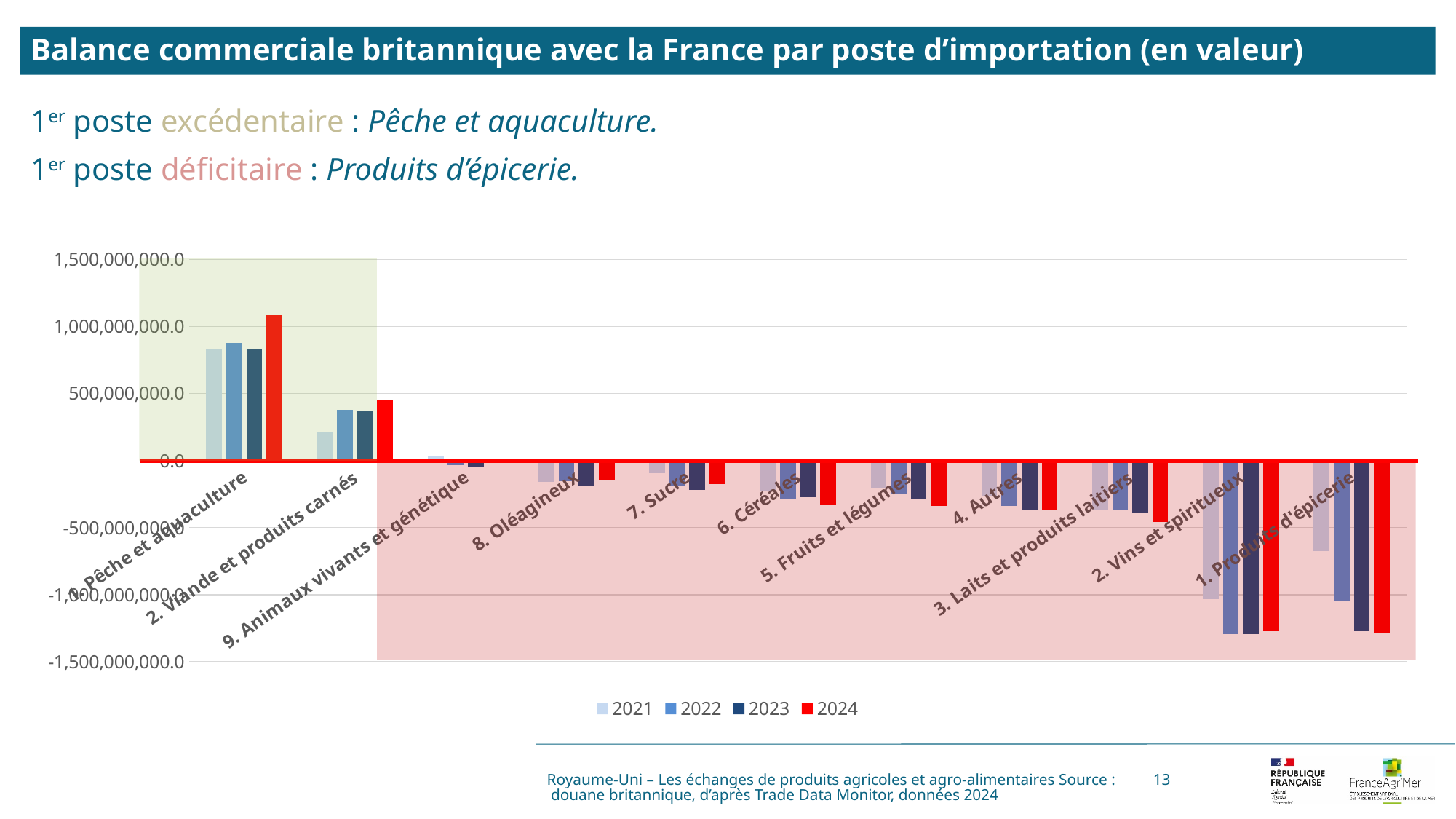
Which category has the lowest (most negative) 2024 value? 1. Produits d'épicerie How many import categories are shown on the x axis? 11 Which category has the highest 2024 value? Pêche et aquaculture Is the 2024 value for 2. Viande et produits carnés greater or less than 500,000,000.0? less What kind of chart is shown on the slide? bar chart Which categories fall inside the green shaded (surplus) area of the chart? Pêche et aquaculture and 2. Viande et produits carnés Is the 2024 value for 1. Produits d'épicerie greater or less than -1,000,000,000.0? less Which colour represents the 2024 series in the legend? red Which is larger, the 2024 value for Pêche et aquaculture or the 2024 value for 2. Viande et produits carnés? Pêche et aquaculture For 1. Produits d'épicerie, does the deficit grow or shrink from 2021 to 2024? grows Is the 2024 value for Pêche et aquaculture greater or less than 1,000,000,000.0? greater How many series does the legend list? 4